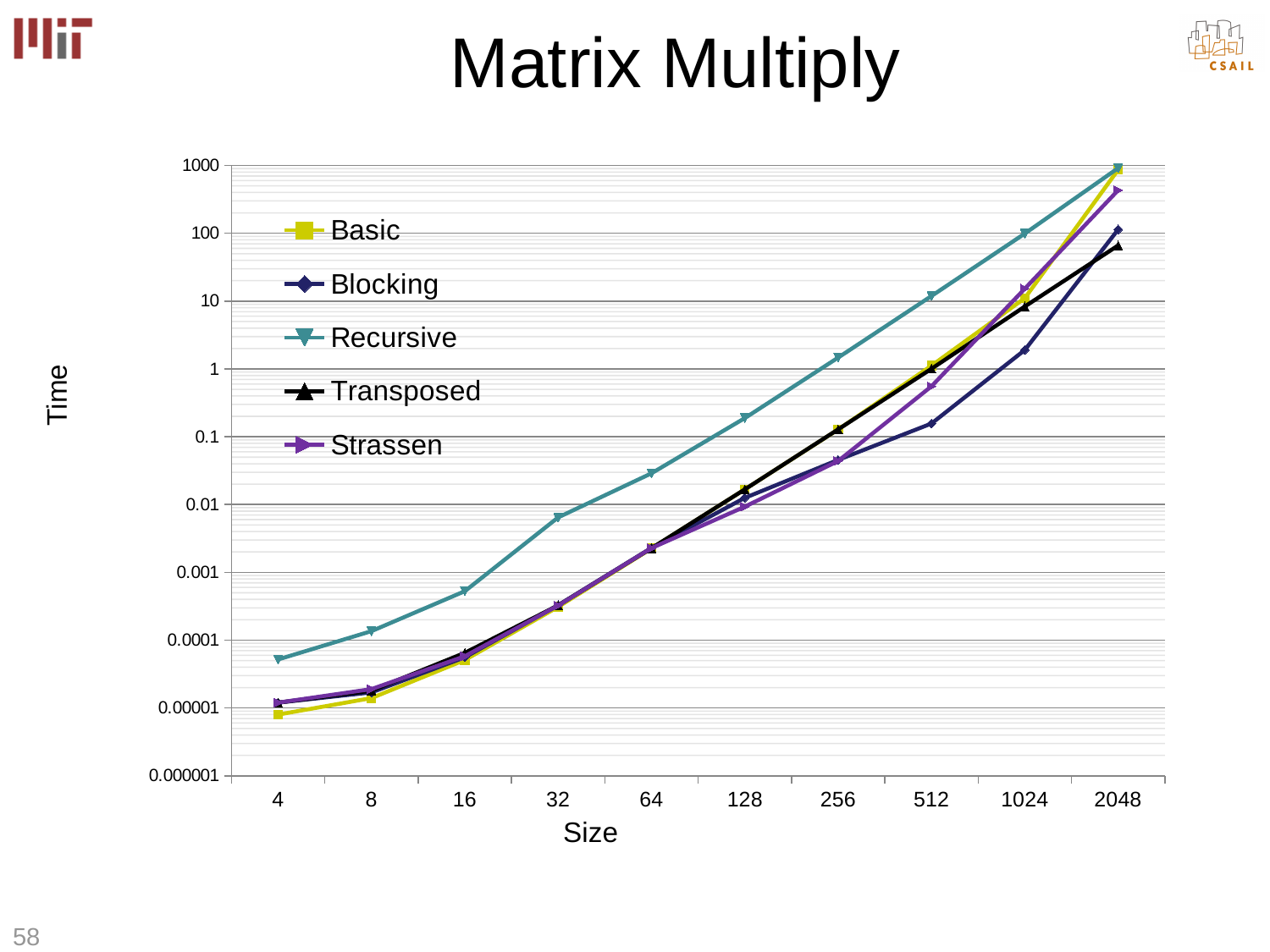
What kind of chart is shown on the slide? line chart Which series has the highest time at size 512? Recursive Is the time for Strassen at size 512 greater or less than 1? less Which series has the lowest time at size 1024? Blocking Is the time for Recursive at size 512 greater or less than 10? greater How many series does the legend list? 5 How many size values are plotted along the x axis? 10 Do the times rise or fall as size increases along the x axis? rise Is the time for Transposed at size 2048 greater or less than 100? less Which series has the lowest time at size 4? Basic Which series has the lowest time at size 2048? Transposed At size 1024, which has the larger time, Blocking or Transposed? Transposed